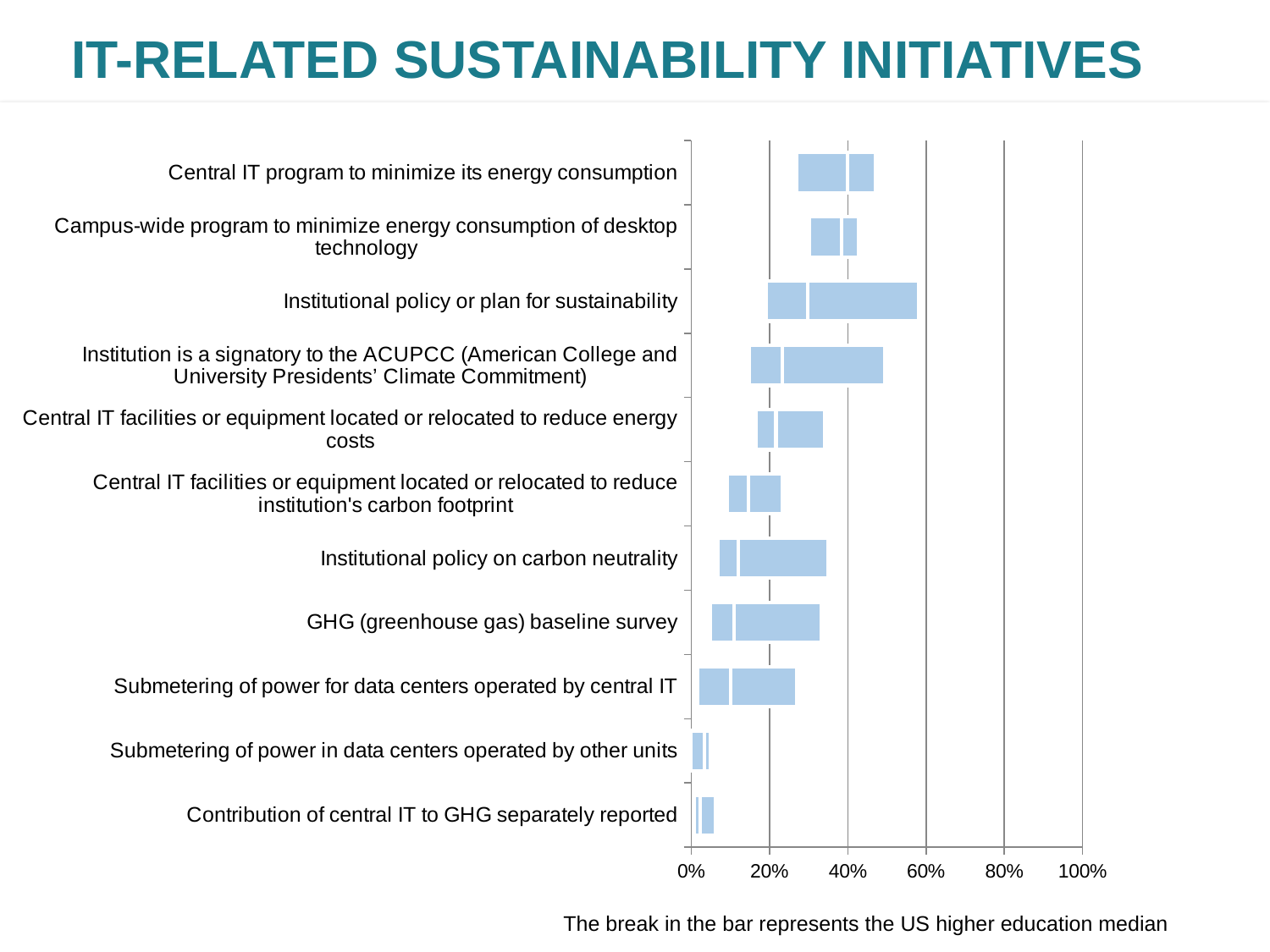
Is the median (the break in the bar) for 'Institutional policy on carbon neutrality' greater or less than 20%? less What kind of chart is shown on the slide? bar chart Is the right end of the bar for 'Institution is a signatory to the ACUPCC' greater or less than 40%? greater Is the right end of the bar for 'Institutional policy or plan for sustainability' greater or less than 60%? less According to the note below the chart, what does the break in each bar represent? The US higher education median How many initiatives (categories) are plotted on the chart? 11 Which initiative's bar extends furthest to the right on the chart? Institutional policy or plan for sustainability Which bar extends further to the right: 'Institutional policy or plan for sustainability' or 'Institution is a signatory to the ACUPCC'? Institutional policy or plan for sustainability What is the highest value shown on the horizontal axis? 100%